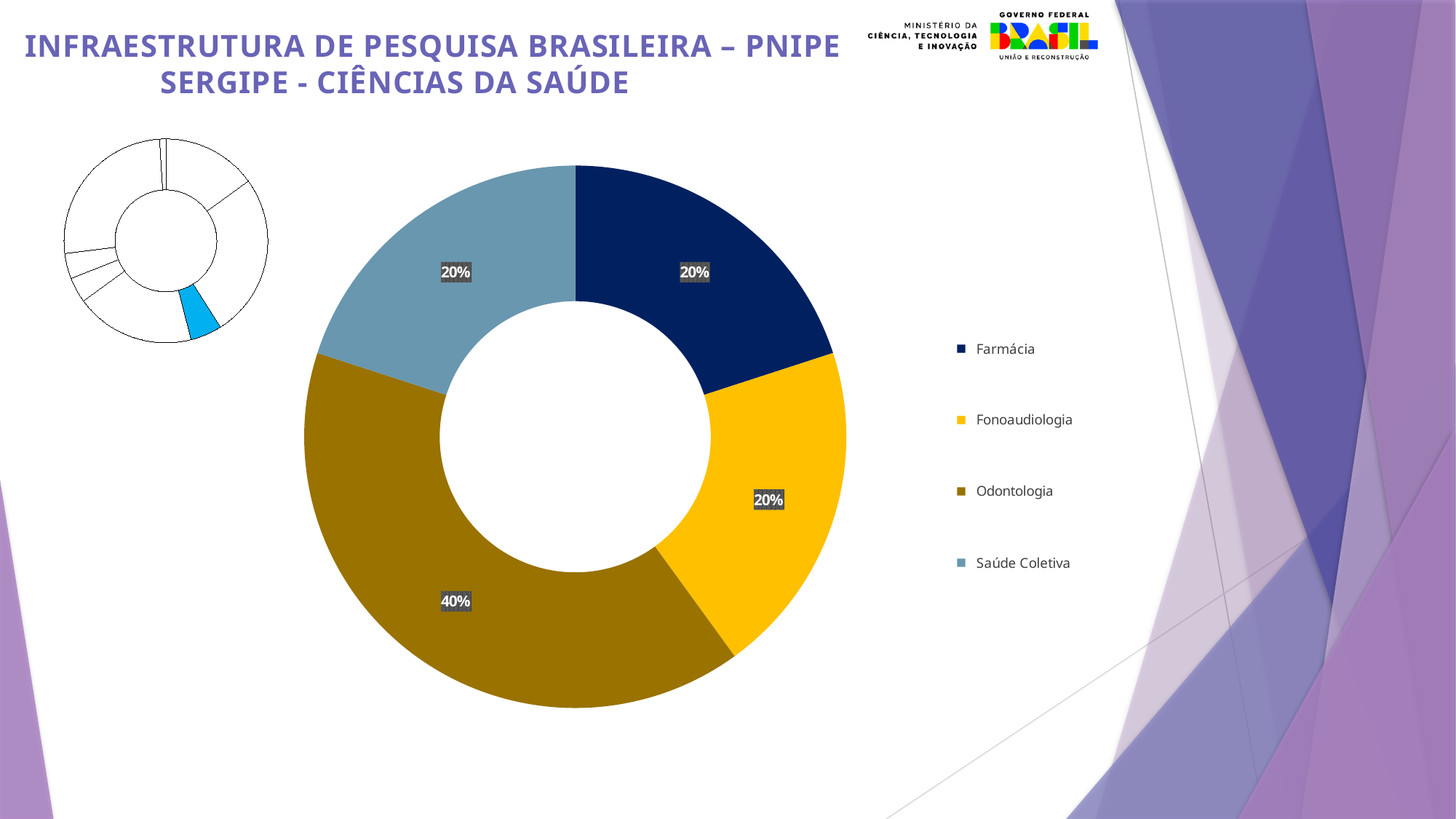
Which category is shown in yellow in the doughnut chart? Fonoaudiologia Which is larger, the share for Odontologia or the share for Saúde Coletiva? Odontologia What kind of chart is shown on the slide? Doughnut chart How many categories in the doughnut chart have a share of 20%? 3 What share of the doughnut chart does Farmácia represent? 20% What share of the doughnut chart does Saúde Coletiva represent? 20% What is the difference in percentage points between Odontologia and Farmácia? 20% How many categories does the doughnut chart show? 4 What share of the doughnut chart does Fonoaudiologia represent? 20% Which category is shown in dark navy blue in the doughnut chart? Farmácia What share of the doughnut chart does Odontologia represent? 40% Which category has the largest share in the doughnut chart? Odontologia